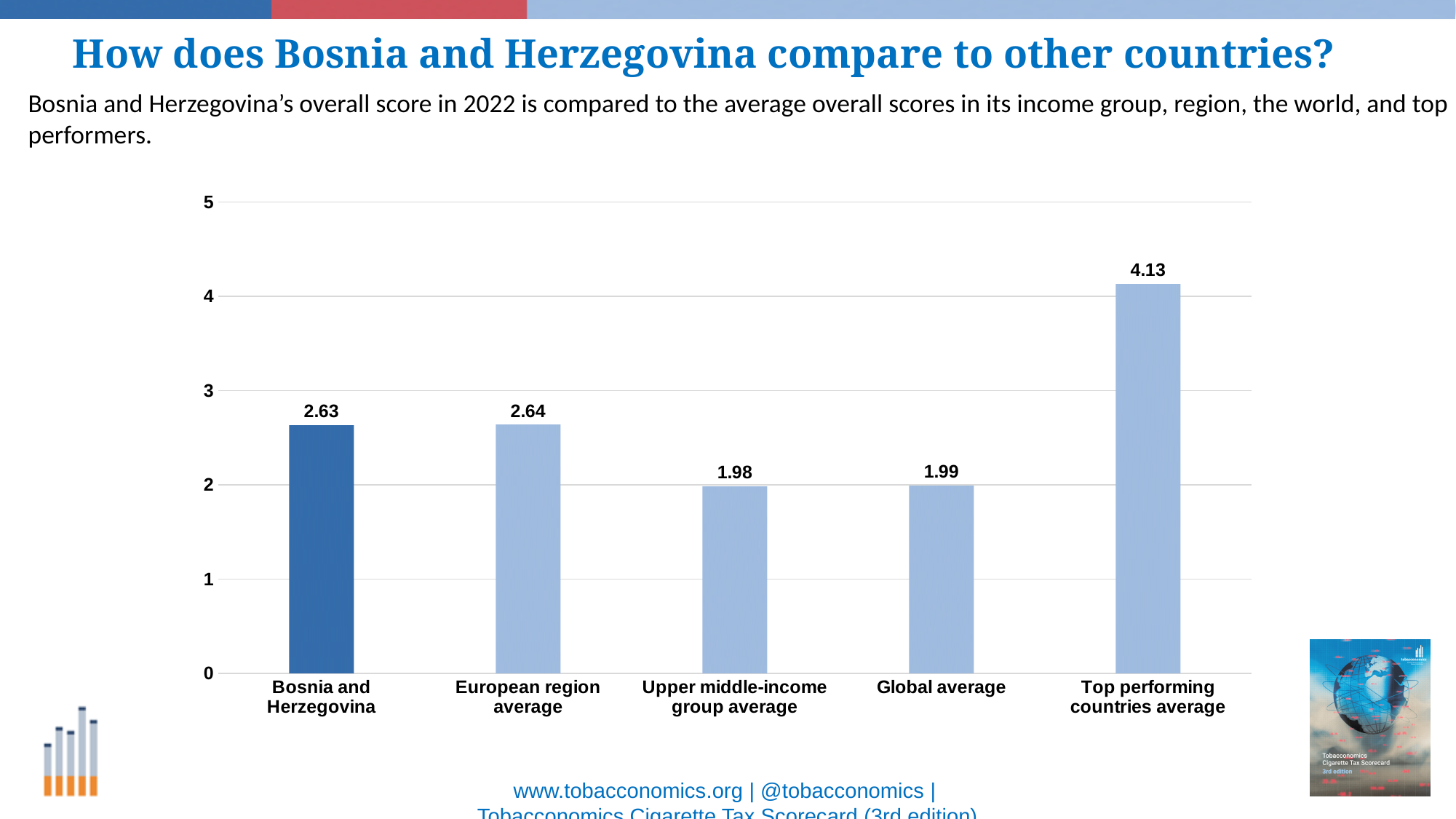
How many categories are shown in the chart? 5 Which is larger, the value for Bosnia and Herzegovina or the Global average? Bosnia and Herzegovina Is the value for the Top performing countries average greater or less than 4? greater What is the value for the Global average? 1.99 What is the value for the Upper middle-income group average? 1.98 Which category has the highest value? Top performing countries average What is the value for Bosnia and Herzegovina? 2.63 What kind of chart is shown on the slide? Bar chart What is the difference between the European region average and the Global average? 0.65 What is the difference between the Top performing countries average and Bosnia and Herzegovina? 1.50 Which bar is shown in a darker blue than the others? Bosnia and Herzegovina What is the value for the Top performing countries average? 4.13